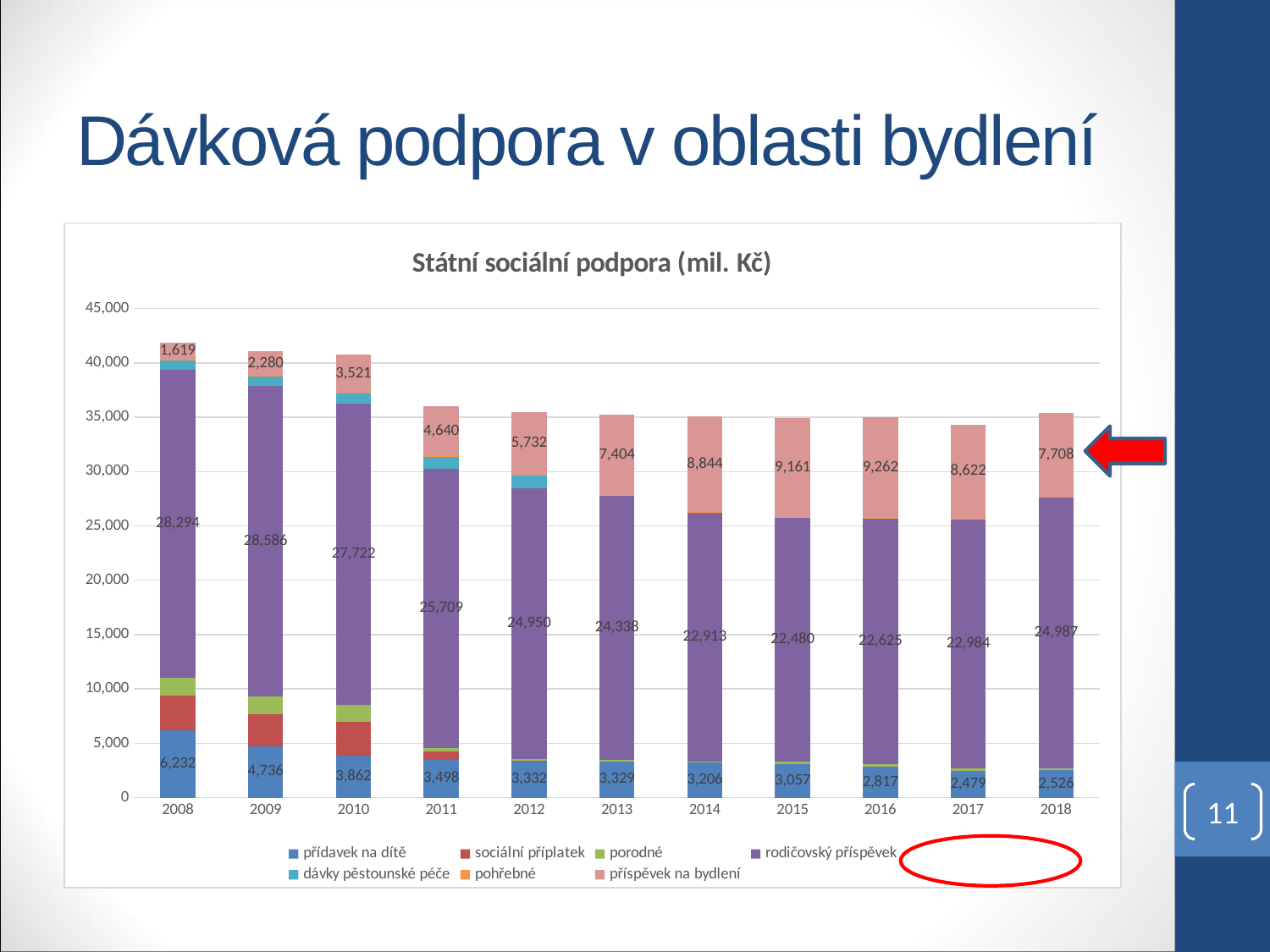
In which year is příspěvek na bydlení highest? 2016 How many series does the legend list? 7 What is the value of rodičovský příspěvek for 2011? 25,709 What is the value of přídavek na dítě for 2008? 6,232 What is the difference between příspěvek na bydlení in 2016 and in 2008? 7,643 Is the total stacked bar for 2008 greater or less than 40,000? greater Which is larger: rodičovský příspěvek in 2009 or in 2018? 2009 What is the value of příspěvek na bydlení for 2018? 7,708 How many years are shown on the x axis? 11 In which year is přídavek na dítě lowest? 2017 What kind of chart is shown on the slide? stacked bar chart Does přídavek na dítě generally rise or fall from 2008 to 2017? fall